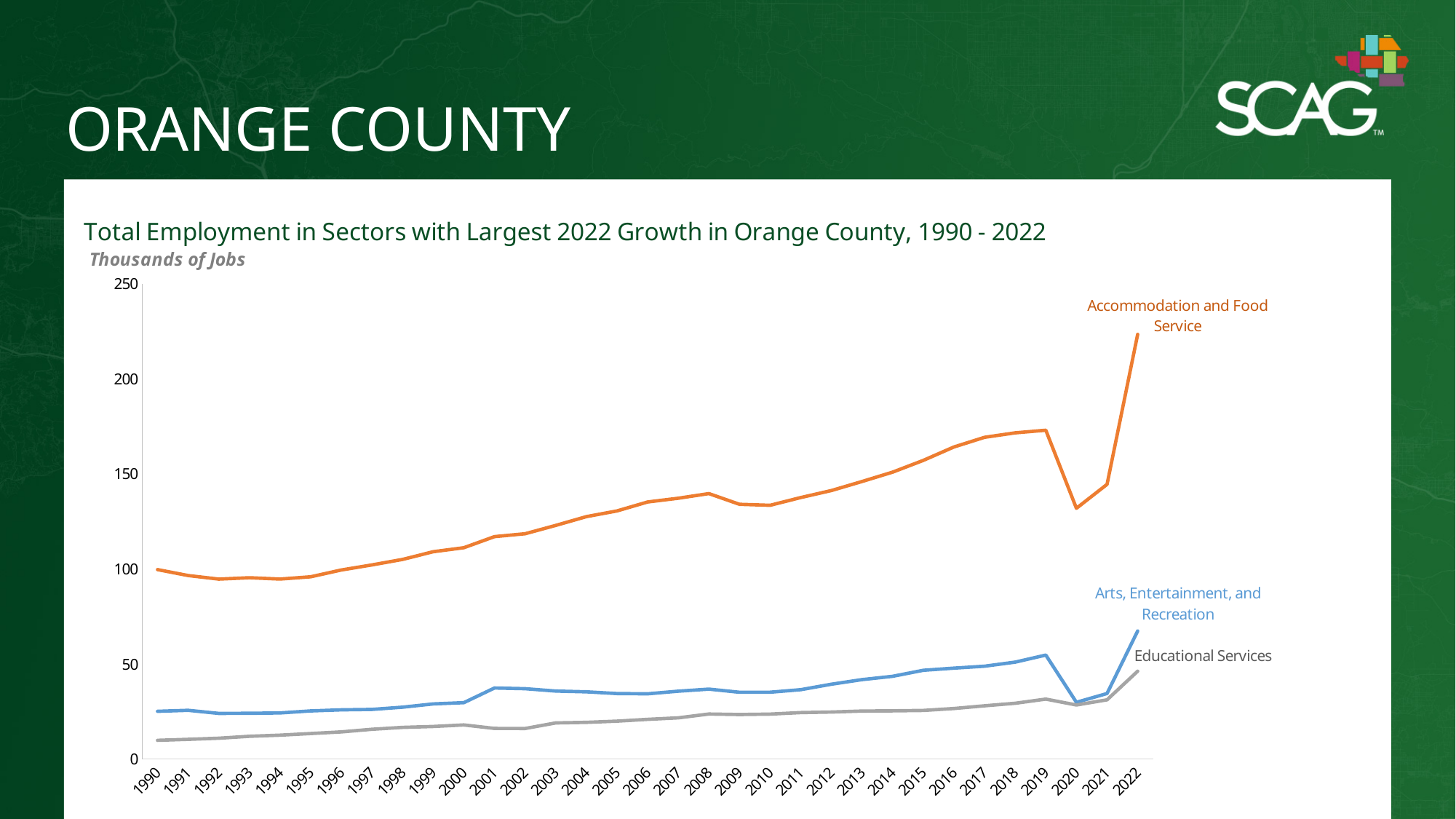
Does employment in Accommodation and Food Service rise or fall between 2019 and 2020? Fall What unit is the y axis of the chart measured in? Thousands of Jobs How many years are shown along the x axis of the chart? 33 What type of chart is shown on the slide? Line chart How many sectors (series) are plotted on the chart? 3 Which sector has the highest employment in 2022? Accommodation and Food Service Is the value for Educational Services in 1990 greater or less than 50? less Is the value for Accommodation and Food Service in 2022 greater or less than 200? greater Which sector has the lowest employment in 1990? Educational Services Is the value for Arts, Entertainment, and Recreation in 2022 greater or less than 50? greater In 2019, which is larger: Arts, Entertainment, and Recreation or Educational Services? Arts, Entertainment, and Recreation